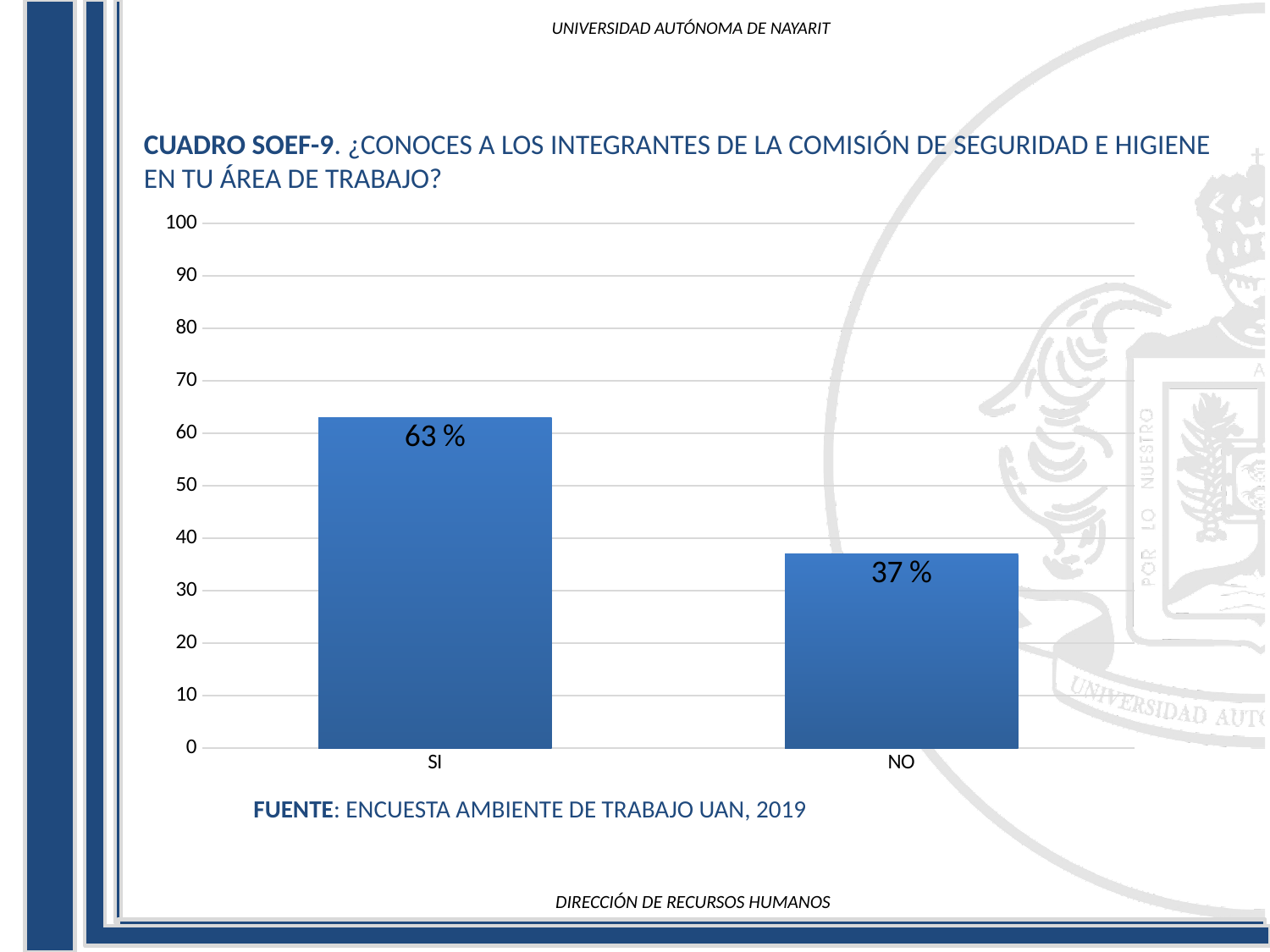
Which category has the highest value? SI How many categories are shown on the x axis? 2 What kind of chart is shown on the slide? bar chart What is the difference between the values for SI and NO? 26 % What is the value for SI? 63 % Which is larger, the value for SI or the value for NO? SI What source is cited below the chart? ENCUESTA AMBIENTE DE TRABAJO UAN, 2019 What is the total of the values for SI and NO? 100 % Is the value for SI greater or less than 50? greater What is the value for NO? 37 % Which category has the lowest value? NO Is the value for NO greater or less than 40? less